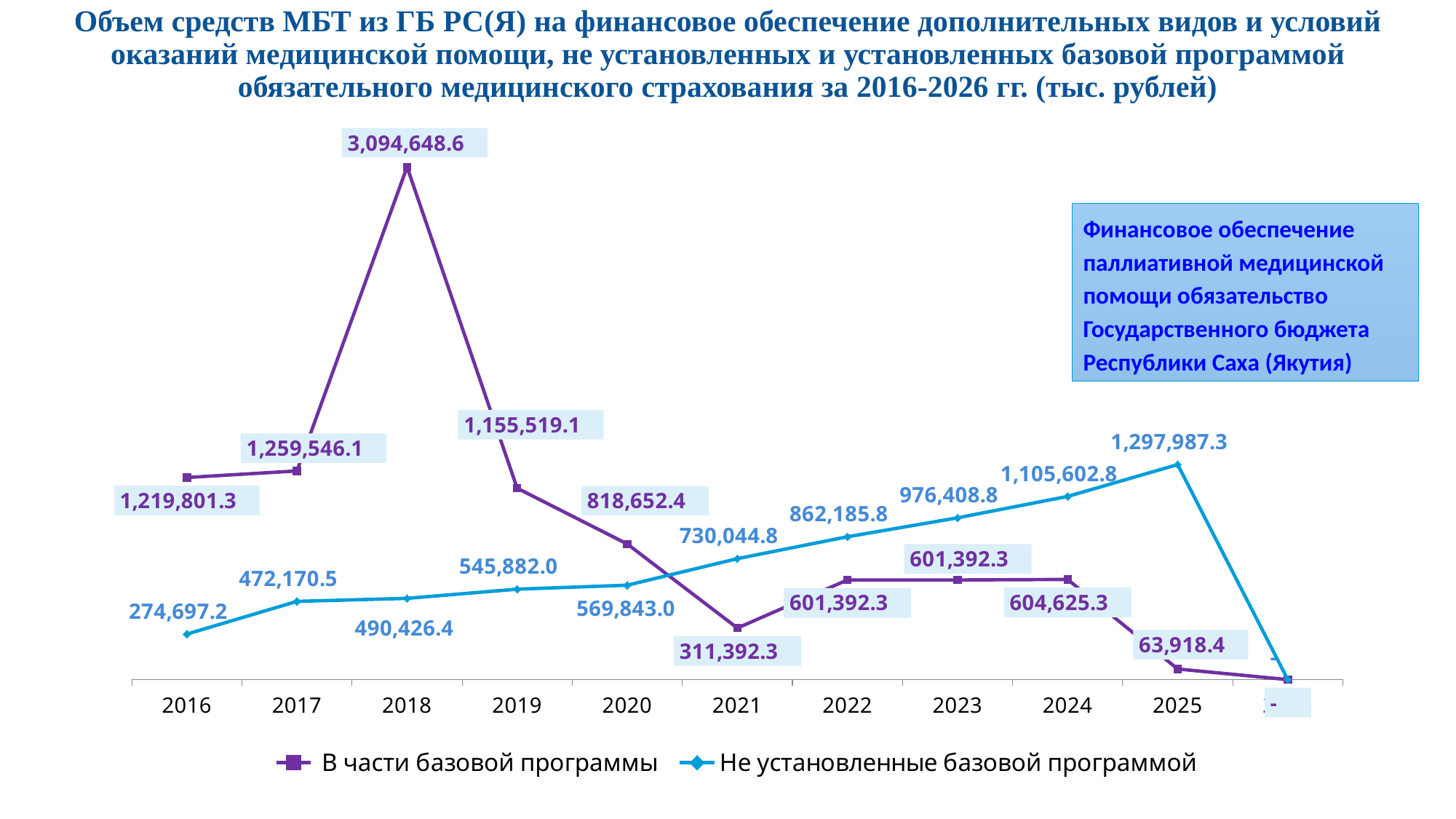
In which year does the 'В части базовой программы' series reach its highest value? 2018 What is the difference between the 'Не установленные базовой программой' values for 2024 and 2023? 129,194.0 What is the value of the 'Не установленные базовой программой' series in 2019? 545,882.0 How many series does the legend list? 2 In 2020, which series has the larger value: 'В части базовой программы' or 'Не установленные базовой программой'? В части базовой программы What is the difference between the 'В части базовой программы' values for 2017 and 2016? 39,744.8 In which year does the 'Не установленные базовой программой' series reach its highest value? 2025 What kind of chart is shown on the slide? Line chart Does the 'Не установленные базовой программой' series rise or fall from 2016 to 2025? Rises What is the value of the 'Не установленные базовой программой' series in 2025? 1,297,987.3 What is the value of the 'В части базовой программы' series in 2018? 3,094,648.6